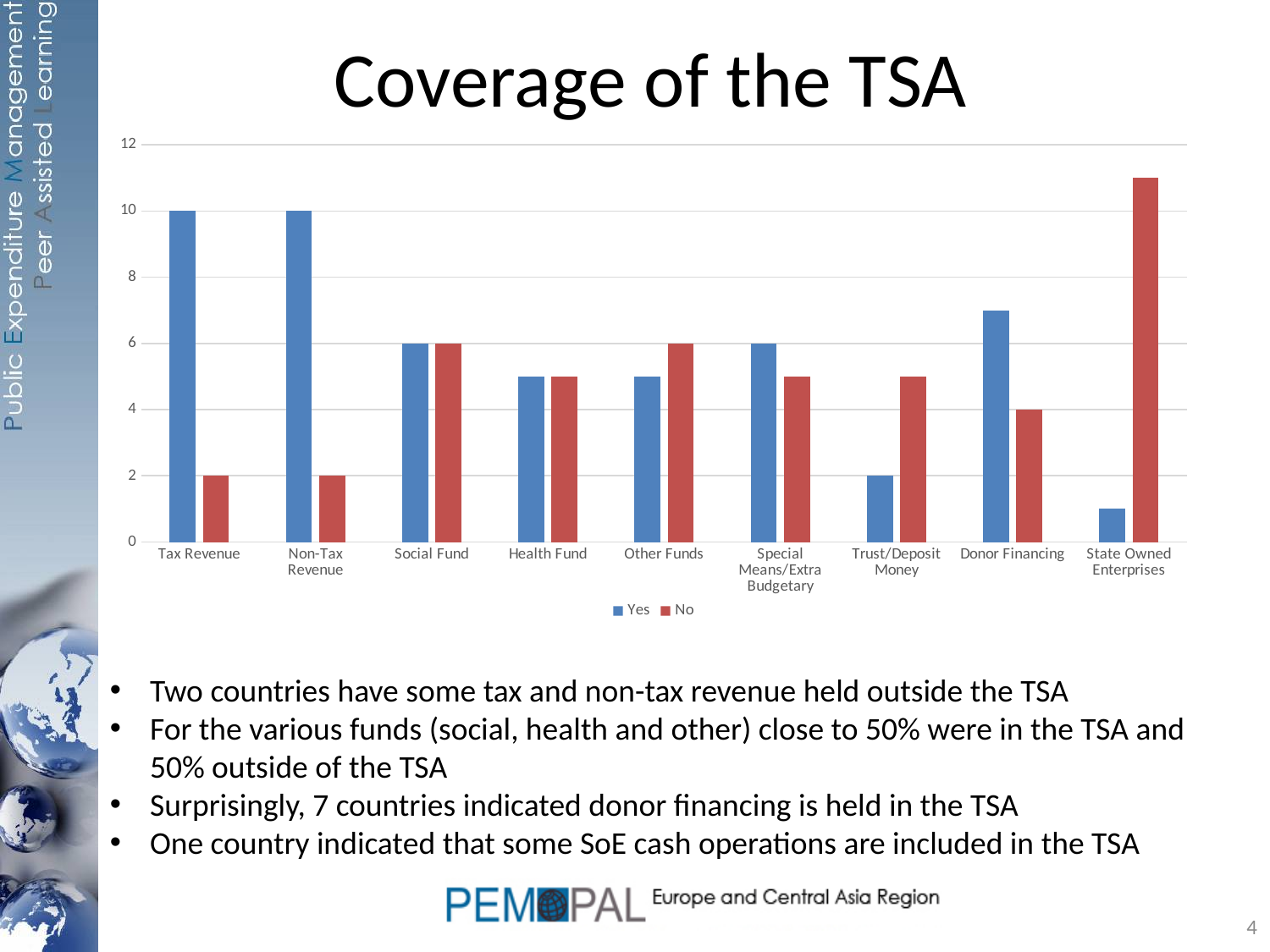
What is the 'No' value for Donor Financing? 4 What is the 'Yes' value for Tax Revenue? 10 What is the 'Yes' value for Social Fund? 6 Is the 'No' value for State Owned Enterprises greater or less than 10? greater What is the 'No' value for Non-Tax Revenue? 2 Which category has the highest 'No' value? State Owned Enterprises How many series does the chart legend list? 2 Which category has the lowest 'Yes' value? State Owned Enterprises What is the difference between the 'Yes' and 'No' values for Tax Revenue? 8 What type of chart is shown on the slide? bar chart For Donor Financing, which is larger, the 'Yes' value or the 'No' value? Yes How many categories are shown along the x axis of the chart? 9